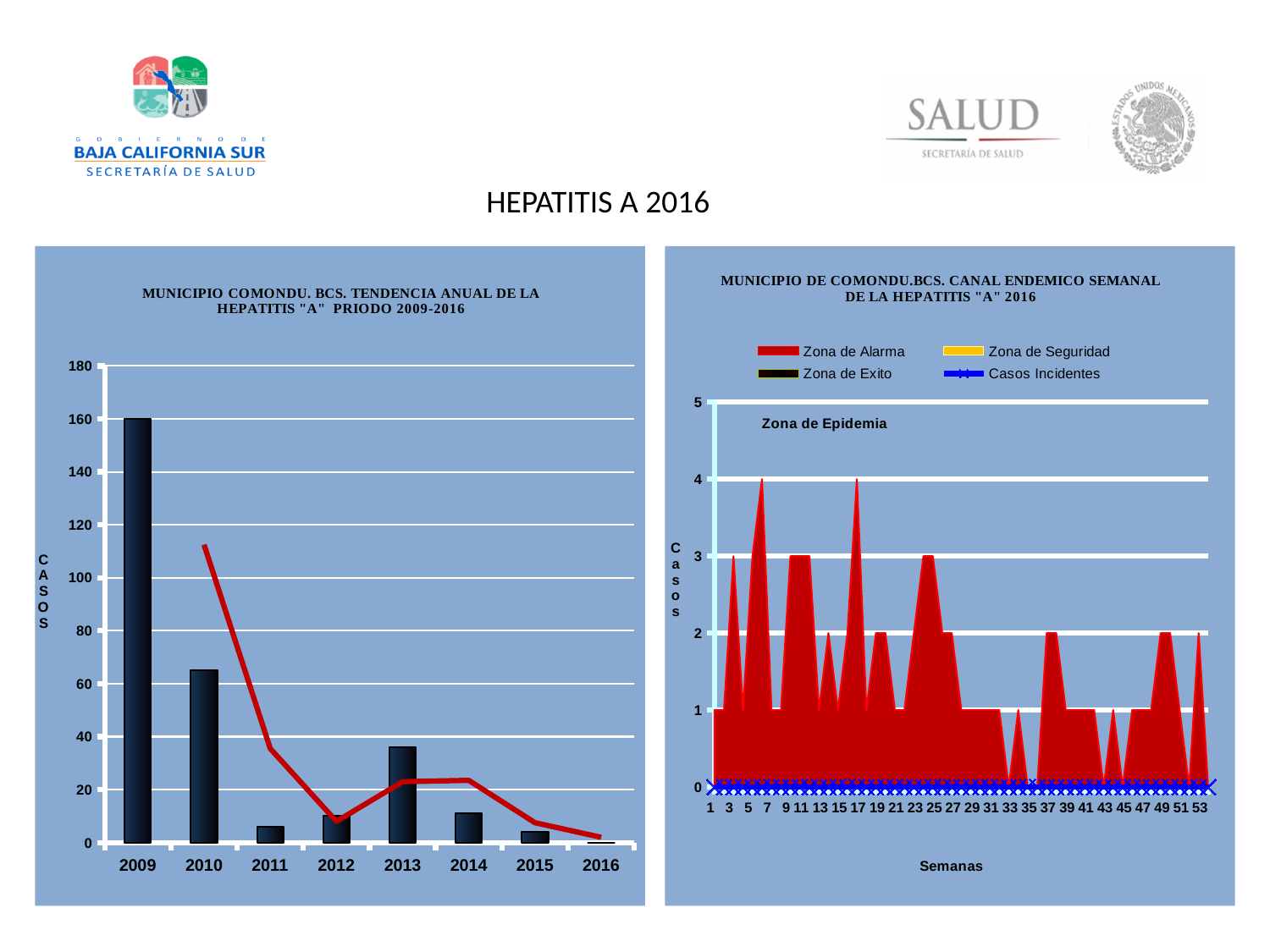
In the left chart (tendencia anual), which year has more cases, 2010 or 2013? 2010 In the left chart (tendencia anual), is the value for 2009 greater or less than 140? greater In the left chart (tendencia anual), which year has the highest number of cases? 2009 In the left chart (tendencia anual), is the value for 2010 greater or less than 80? less In the left chart (tendencia anual), which year has the lowest number of cases? 2016 In the right chart (canal endemico semanal), what is the label of the x axis? Semanas In the left chart (tendencia anual), do the cases generally rise or fall from 2009 to 2016? fall In the right chart (canal endemico semanal), how many entries does the legend list? 4 In the left chart (tendencia anual), is the value for 2013 greater or less than 20? greater What kind of chart is the left chart, 'Municipio Comondu. BCS. Tendencia anual de la Hepatitis A periodo 2009-2016'? Bar chart with a trend line In the right chart (canal endemico semanal), what is the highest value shown on the y axis? 5 In the left chart (tendencia anual), how many years are shown on the x axis? 8